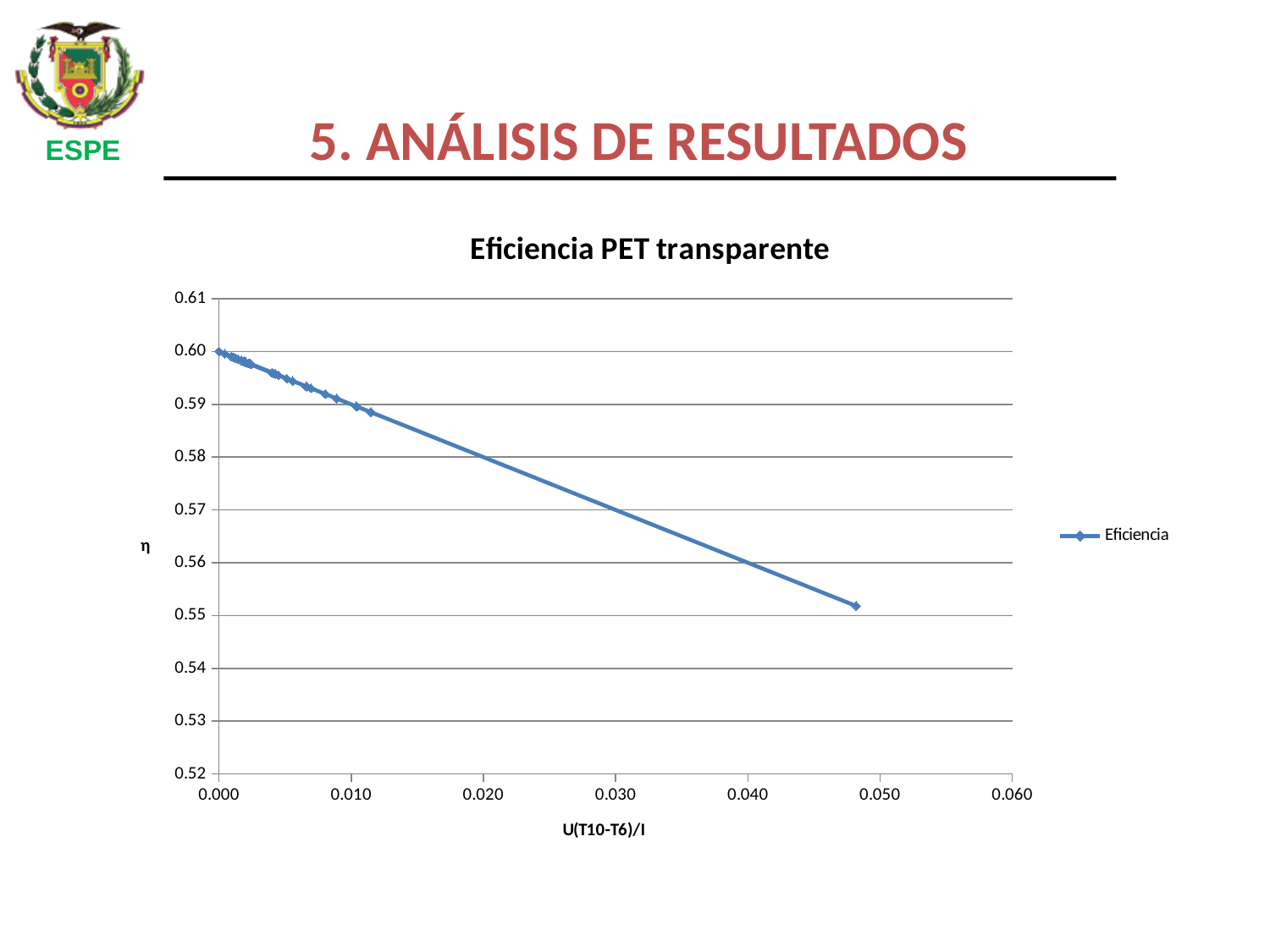
Which has the larger Eficiencia value: the leftmost data point (x = 0.000) or the rightmost data point (near x = 0.048)? the leftmost data point (x = 0.000) Is the Eficiencia value at the rightmost data point (near 0.048 on the x axis) greater or less than 0.54? greater Is the Eficiencia value at the leftmost data point (x = 0.000) greater or less than 0.59? greater What kind of chart is shown on the slide? line chart What is the name of the series shown in the legend? Eficiencia How many series does the legend list? 1 Do the values of Eficiencia rise or fall as U(T10-T6)/I increases along the x axis? fall What is the title of the chart? Eficiencia PET transparente Is the Eficiencia value at the leftmost data point (x = 0.000) greater or less than 0.58? greater